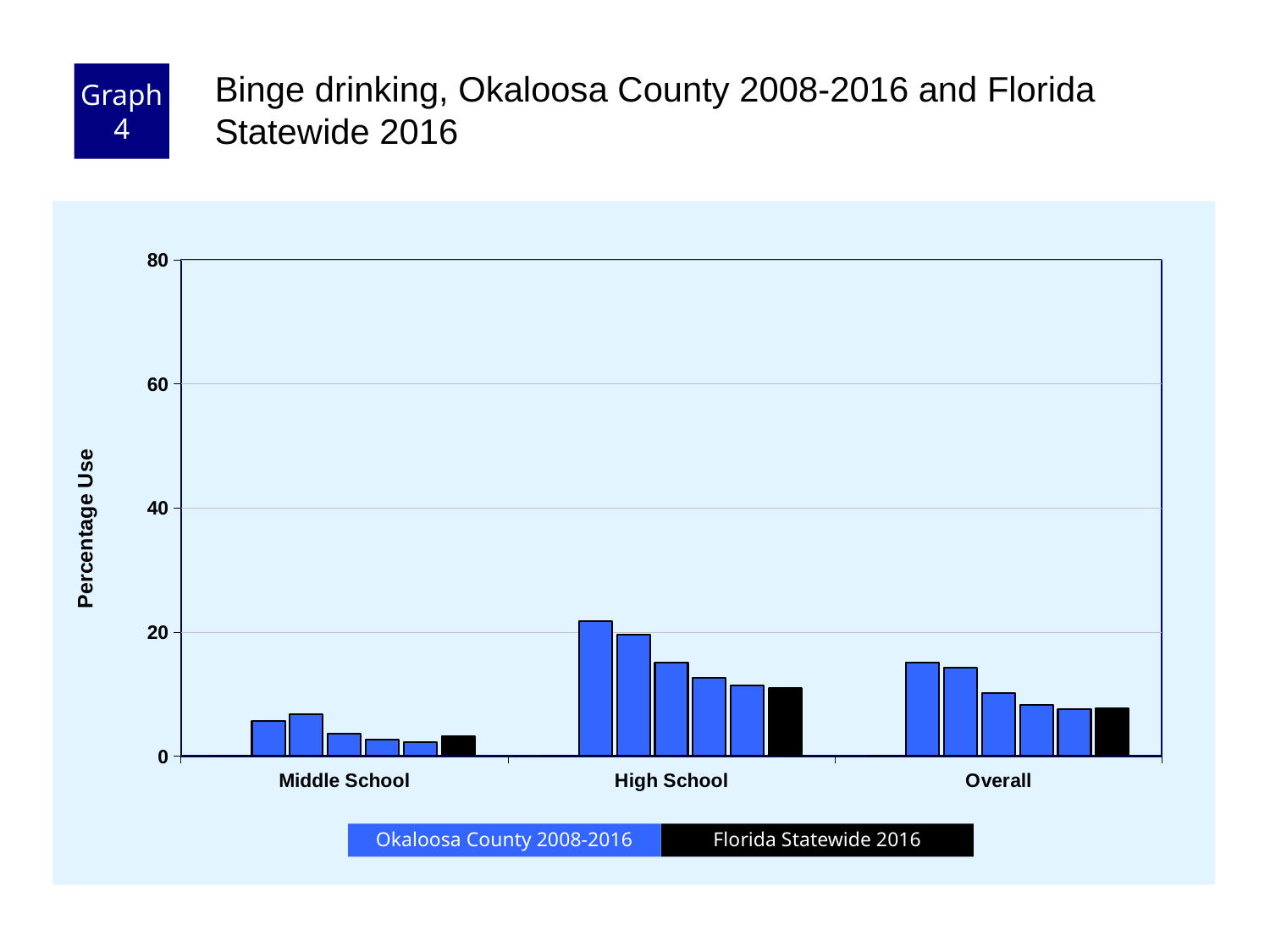
Is the Florida Statewide 2016 value for Overall greater or less than 20? less Is the tallest High School bar greater or less than 20? greater How many series does the legend list? 2 What colour are the Florida Statewide 2016 bars? black What kind of chart is shown on the slide? bar chart What is the label on the y axis? Percentage Use How many categories are shown on the x axis? 3 Which category has the lowest bars overall? Middle School Which is larger, the Florida Statewide 2016 value for High School or for Middle School? High School Which category has the tallest bar? High School Do the Okaloosa County 2008-2016 bars for High School rise or fall from left to right? fall Is the Florida Statewide 2016 value for Middle School greater or less than 20? less